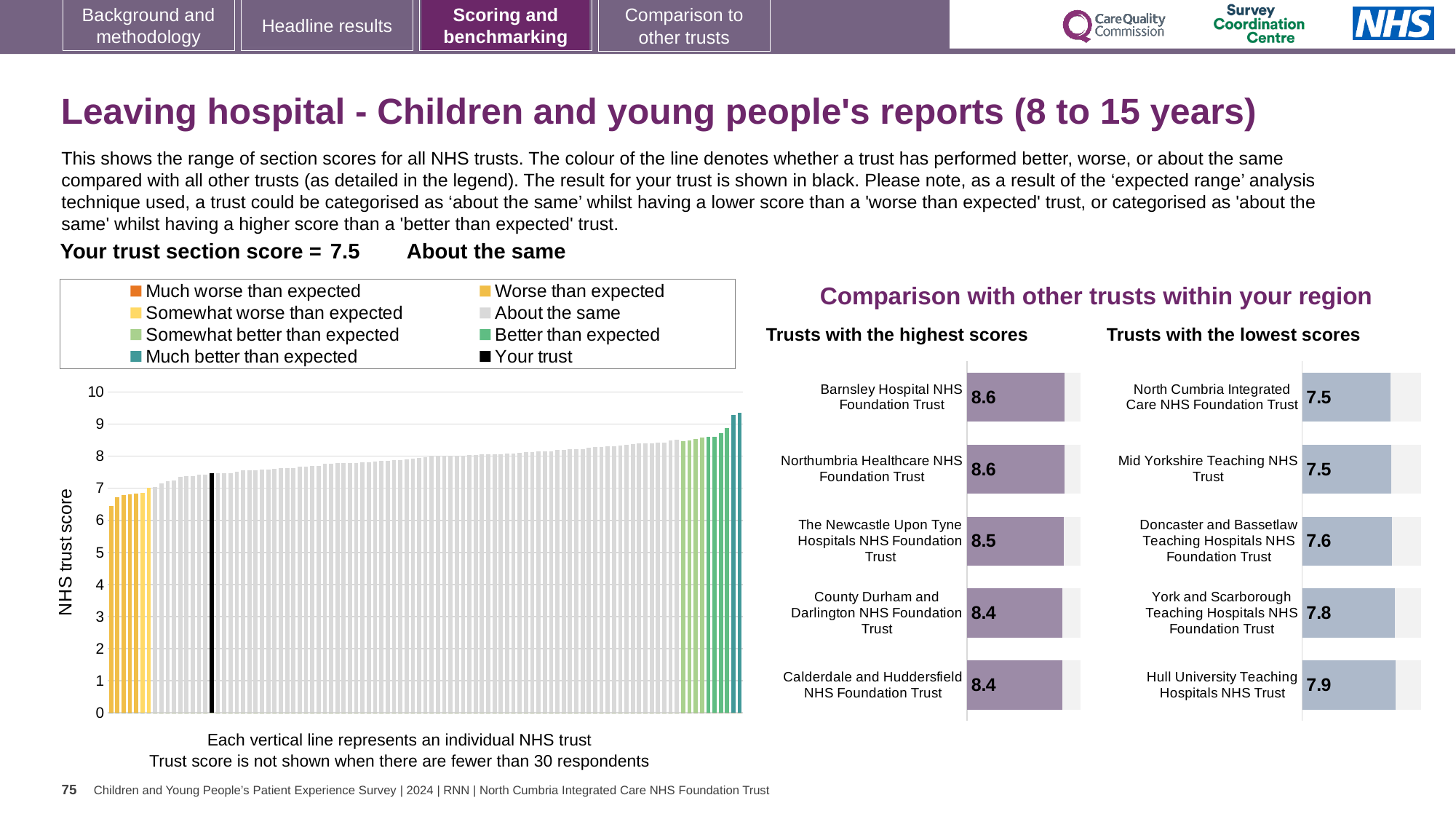
How many trusts are shown in the 'Trusts with the highest scores' chart? 5 How many entries does the legend above the large chart on the left list? 8 In the 'Trusts with the lowest scores' chart, which trust has the highest score? Hull University Teaching Hospitals NHS Trust What kind of chart is the large chart on the left showing NHS trust scores? Bar chart In the 'Trusts with the lowest scores' chart, what is the score for Hull University Teaching Hospitals NHS Trust? 7.9 In the 'Trusts with the lowest scores' chart, what is the score for Doncaster and Bassetlaw Teaching Hospitals NHS Foundation Trust? 7.6 In the large chart on the left, is the value of the lowest bar greater or less than 7? less In the 'Trusts with the highest scores' chart, what is the difference between the scores of Barnsley Hospital NHS Foundation Trust and Calderdale and Huddersfield NHS Foundation Trust? 0.2 In the 'Trusts with the lowest scores' chart, which has the higher score: York and Scarborough Teaching Hospitals NHS Foundation Trust or Doncaster and Bassetlaw Teaching Hospitals NHS Foundation Trust? York and Scarborough Teaching Hospitals NHS Foundation Trust In the 'Trusts with the lowest scores' chart, what is the difference between the scores of Hull University Teaching Hospitals NHS Trust and North Cumbria Integrated Care NHS Foundation Trust? 0.4 In the 'Trusts with the highest scores' chart, what is the score for Barnsley Hospital NHS Foundation Trust? 8.6 In the large chart on the left, do the trust scores rise or fall from left to right? Rise